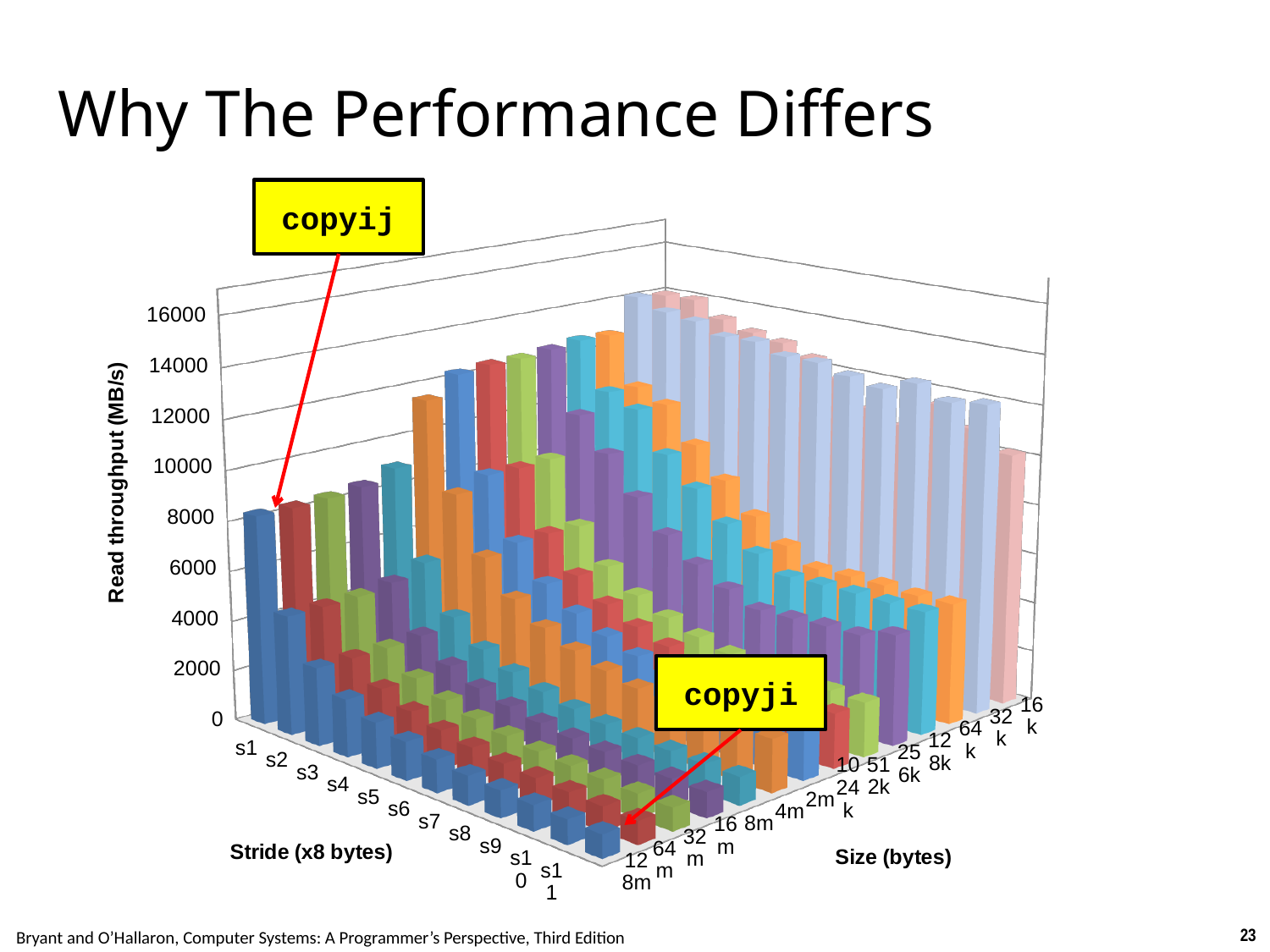
What is the first stride label shown on the stride axis? s1 Is the read throughput for stride s1 at size 128m greater or less than 2000? greater How many stride categories are shown along the stride axis? 11 What kind of chart is shown on the slide? bar chart What are the two horizontal axis titles of the chart? Stride (x8 bytes) and Size (bytes) Is the read throughput for stride s11 at size 128m greater or less than 4000? less Along the stride axis from s1 to s11 at size 128m, does read throughput rise or fall? fall What is the highest tick value shown on the read throughput axis? 16000 How many size categories are shown along the size axis? 14 What is the lowest tick value shown on the read throughput axis? 0 What is the title of the vertical axis of the chart? Read throughput (MB/s) Which is larger at size 128m: the read throughput for stride s1 or for stride s11? s1